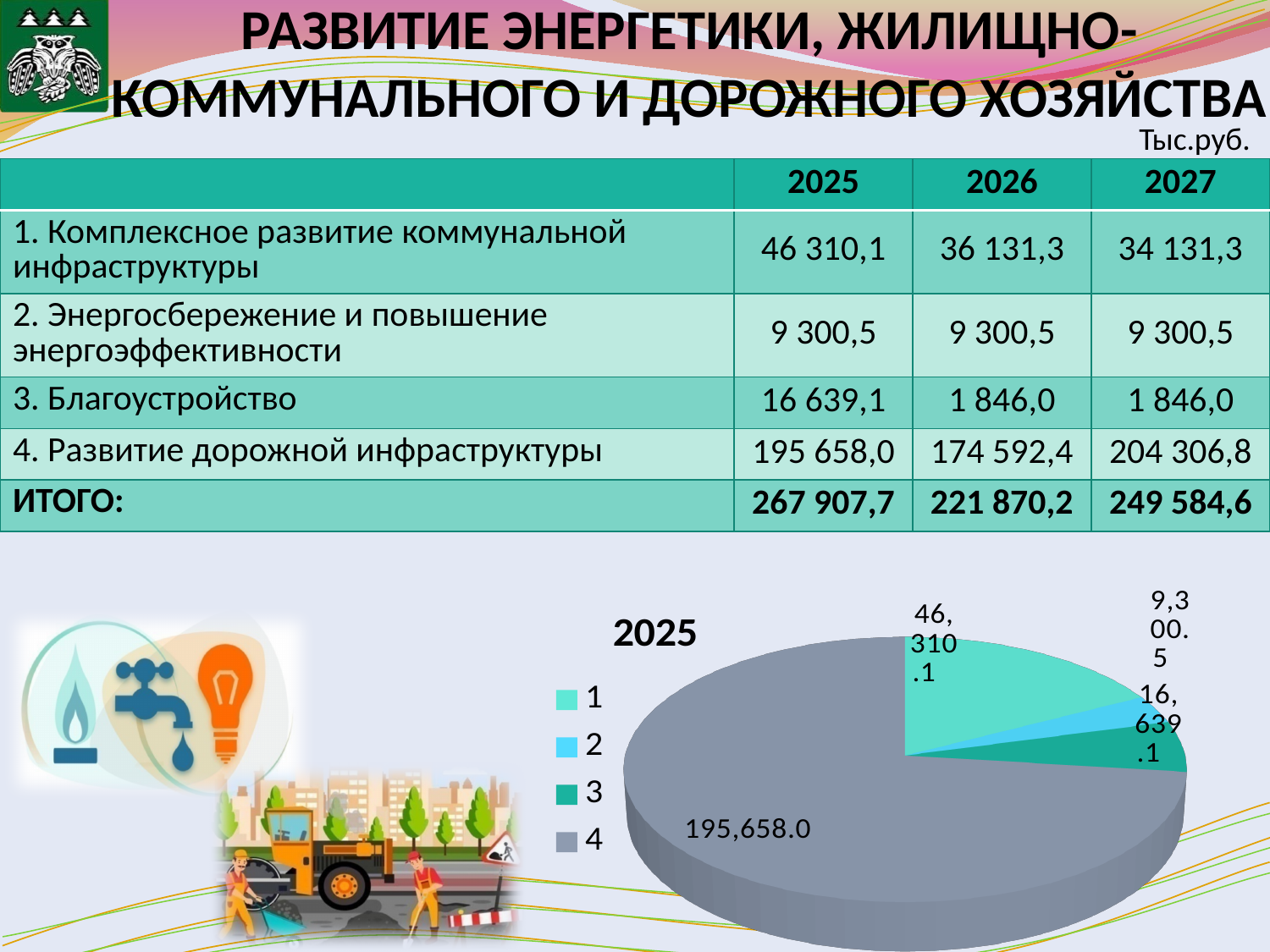
How many slices does the pie chart have? 4 What is the value of slice 4 in the pie chart? 195,658.0 What is the value of slice 2 in the pie chart? 9,300.5 What is the title of the pie chart? 2025 What type of chart is shown on the slide? pie chart Which slice of the pie chart is the smallest? 2 What is the difference between the values of slice 4 and slice 1 in the pie chart? 149,347.9 How many series does the legend of the pie chart list? 4 What is the value of slice 1 in the pie chart? 46,310.1 Which is larger in the pie chart, slice 1 or slice 3? slice 1 Which slice of the pie chart is the largest? 4 What is the value of slice 3 in the pie chart? 16,639.1